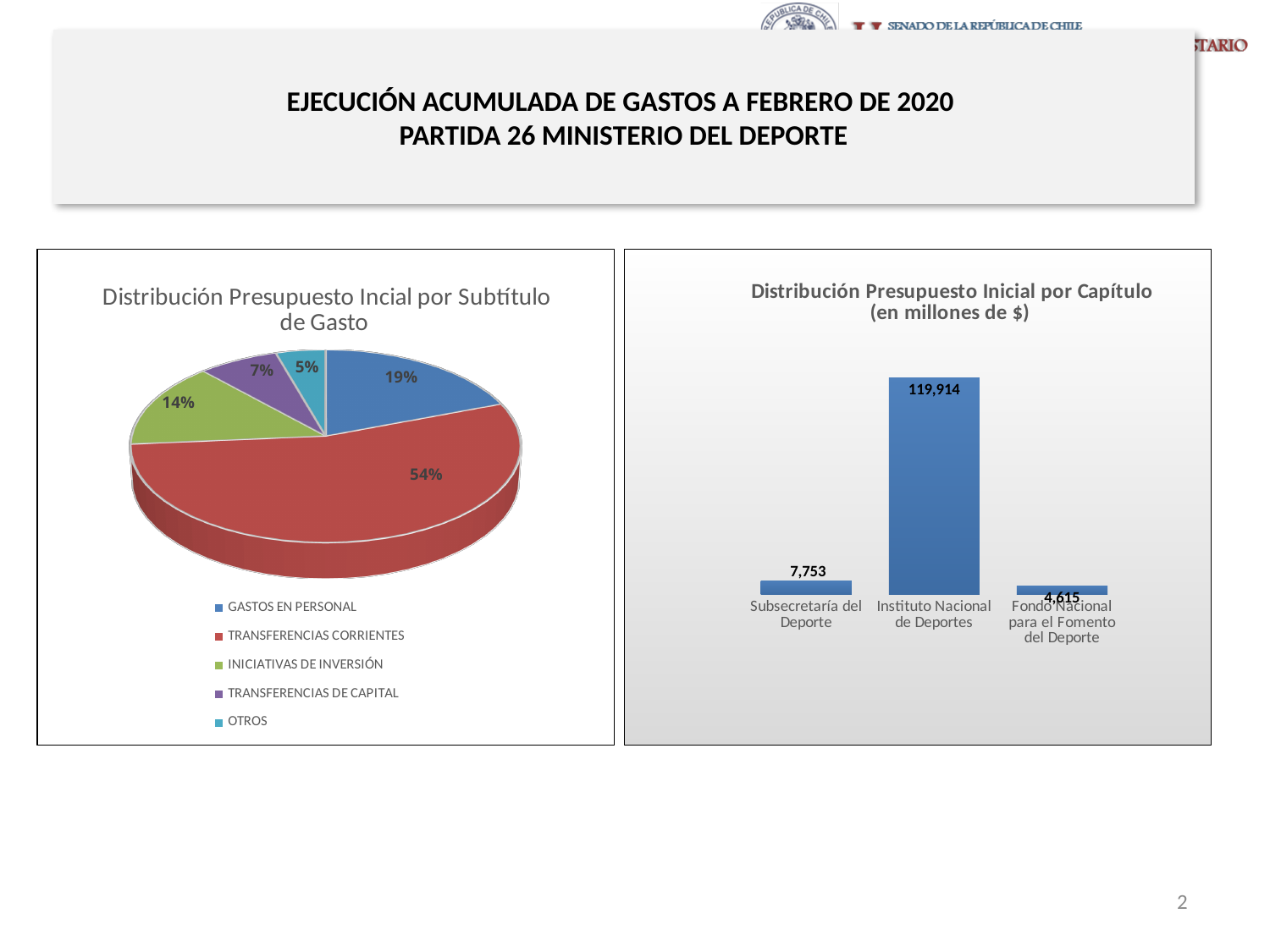
What kind of chart is the left chart 'Distribución Presupuesto Incial por Subtítulo de Gasto'? Pie chart In the right chart 'Distribución Presupuesto Inicial por Capítulo', what is the difference between Subsecretaría del Deporte and Fondo Nacional para el Fomento del Deporte? 3,138 In the left chart 'Distribución Presupuesto Incial por Subtítulo de Gasto', which category has the largest slice? TRANSFERENCIAS CORRIENTES In the right chart 'Distribución Presupuesto Inicial por Capítulo', which category has the lowest value? Fondo Nacional para el Fomento del Deporte What kind of chart is the right chart 'Distribución Presupuesto Inicial por Capítulo'? Bar chart In the left chart 'Distribución Presupuesto Incial por Subtítulo de Gasto', which category has the smallest slice? OTROS In the left chart 'Distribución Presupuesto Incial por Subtítulo de Gasto', what share does GASTOS EN PERSONAL have? 19% In the left chart 'Distribución Presupuesto Incial por Subtítulo de Gasto', what is the difference in percentage points between INICIATIVAS DE INVERSIÓN and TRANSFERENCIAS DE CAPITAL? 7 percentage points In the right chart 'Distribución Presupuesto Inicial por Capítulo', what is the value for Instituto Nacional de Deportes? 119,914 In the left chart 'Distribución Presupuesto Incial por Subtítulo de Gasto', what share does TRANSFERENCIAS CORRIENTES have? 54% In the right chart 'Distribución Presupuesto Inicial por Capítulo', what is the value for Subsecretaría del Deporte? 7,753 In the left chart 'Distribución Presupuesto Incial por Subtítulo de Gasto', how many categories does the legend list? 5